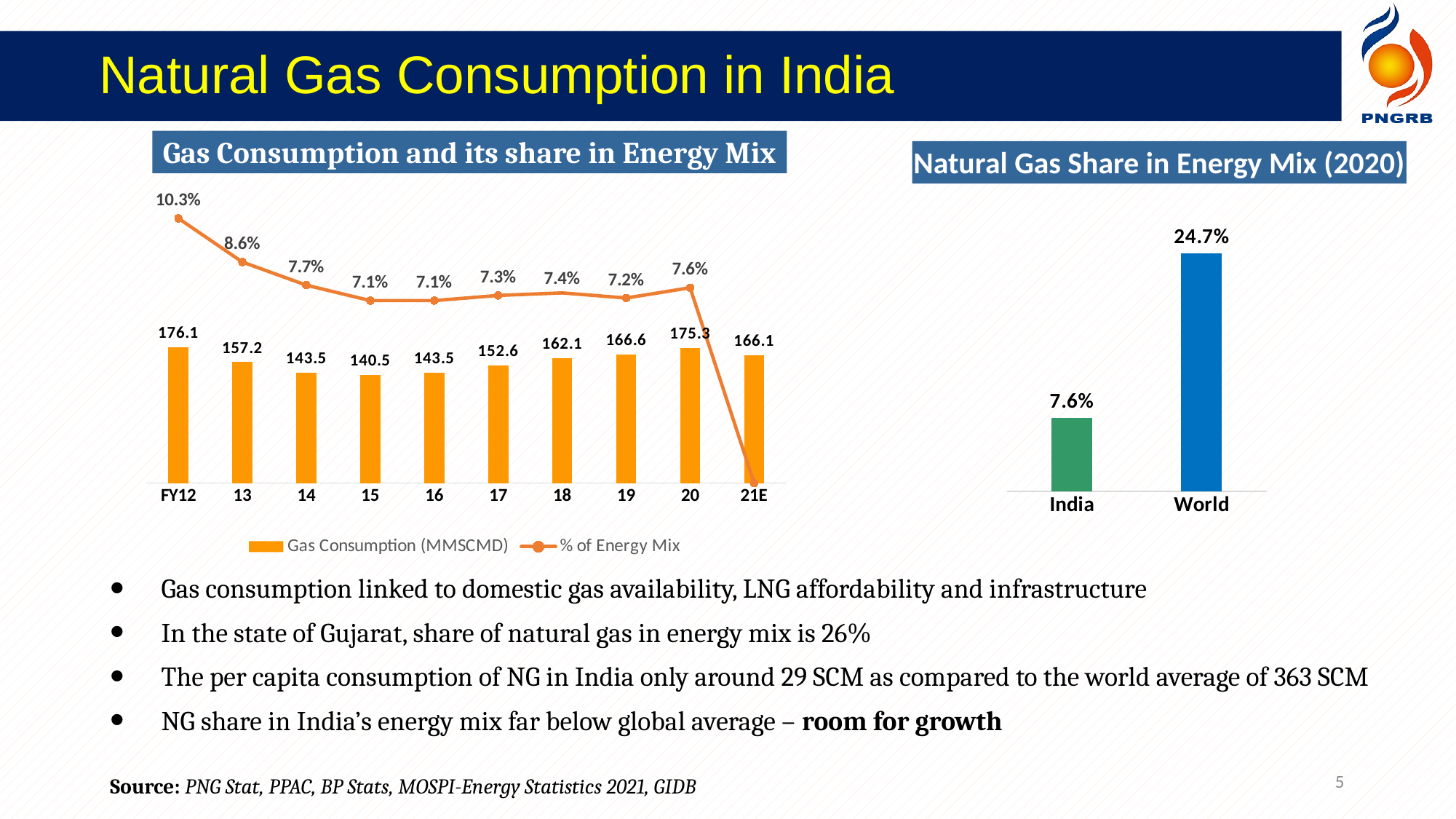
In the 'Gas Consumption and its share in Energy Mix' chart, what is the % of Energy Mix value for 14? 7.7% In the 'Gas Consumption and its share in Energy Mix' chart, which year has the highest gas consumption? FY12 In the 'Gas Consumption and its share in Energy Mix' chart, what is the gas consumption for FY12? 176.1 In the 'Gas Consumption and its share in Energy Mix' chart, does the % of Energy Mix rise or fall from FY12 to 15? fall What kind of chart is the 'Natural Gas Share in Energy Mix (2020)' chart? bar chart In the 'Natural Gas Share in Energy Mix (2020)' chart, what is the difference between the World and India values? 17.1% In the 'Gas Consumption and its share in Energy Mix' chart, which is larger, the gas consumption for 18 or for 17? 18 In the 'Gas Consumption and its share in Energy Mix' chart, how many years are shown on the x axis? 10 In the 'Gas Consumption and its share in Energy Mix' chart, which year has the lowest gas consumption? 15 In the 'Natural Gas Share in Energy Mix (2020)' chart, what is the value for World? 24.7% In the 'Gas Consumption and its share in Energy Mix' chart, what is the difference in gas consumption between 20 and 21E? 9.2 In the 'Gas Consumption and its share in Energy Mix' chart, how many series does the legend list? 2